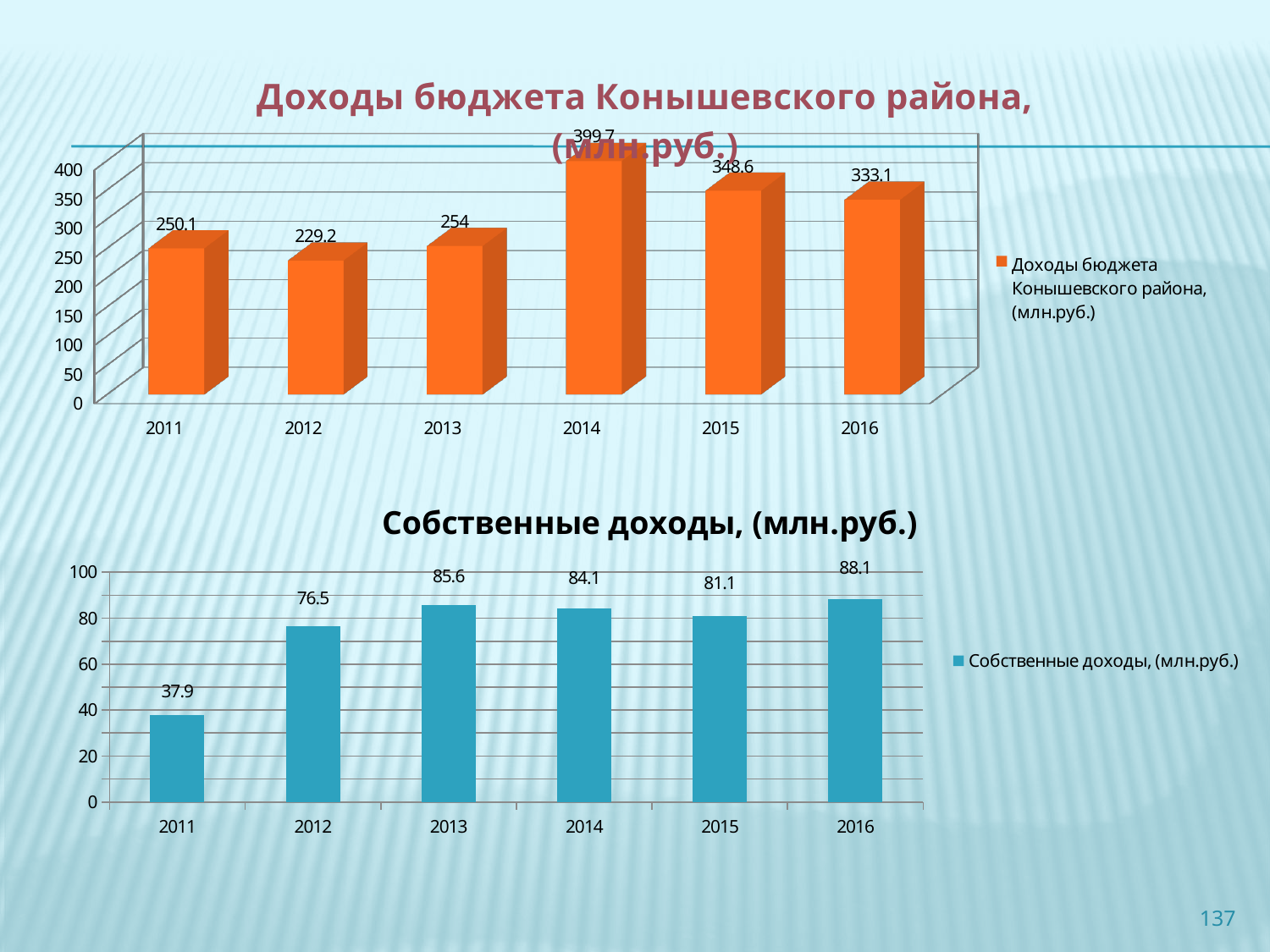
In the top chart (Доходы бюджета Конышевского района), what is the value for 2014? 399.7 In the top chart (Доходы бюджета Конышевского района), what is the difference between the values for 2015 and 2016? 15.5 In the bottom chart (Собственные доходы), what is the value for 2011? 37.9 In the top chart (Доходы бюджета Конышевского района), which year has the highest value? 2014 In the bottom chart (Собственные доходы), which is larger, the value for 2013 or the value for 2015? 2013 In the top chart (Доходы бюджета Конышевского района), which year has the lowest value? 2012 What kind of chart is the bottom chart (Собственные доходы)? Bar chart In the bottom chart (Собственные доходы), what is the value for 2016? 88.1 In the top chart (Доходы бюджета Конышевского района), how many years are shown on the x axis? 6 In the bottom chart (Собственные доходы), which year has the lowest value? 2011 In the top chart (Доходы бюджета Конышевского района), what is the value for 2012? 229.2 In the bottom chart (Собственные доходы), what is the difference between the values for 2012 and 2011? 38.6